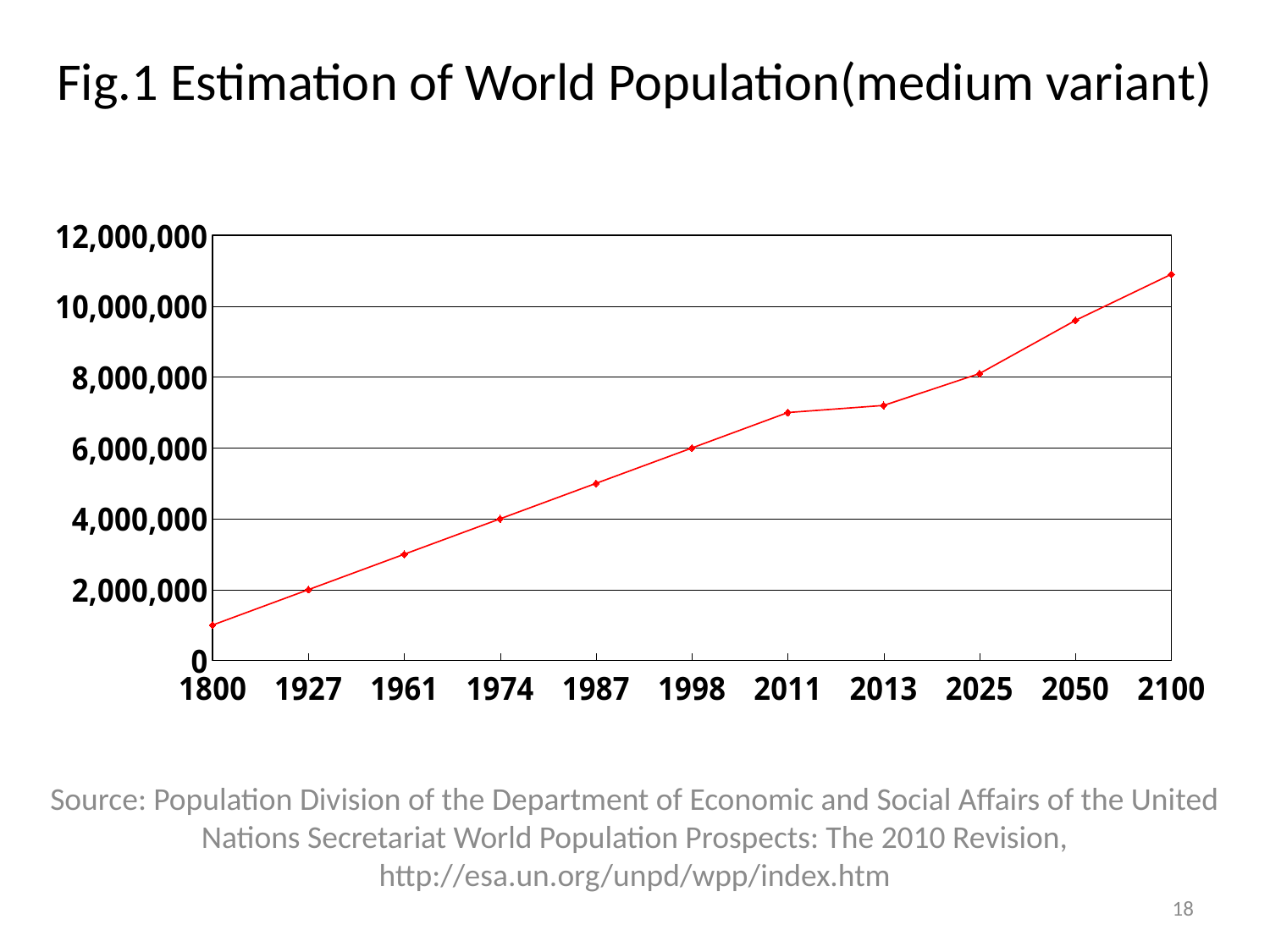
What is the value for 1998? 6,000,000 How many data points are plotted on the line? 11 Which year has the lowest value? 1800 What kind of chart is shown on the slide? line chart Is the value for 1800 greater or less than 2,000,000? less Is the value for 2100 greater or less than 10,000,000? greater What is the title of the chart? Fig.1 Estimation of World Population(medium variant) Which year has the highest value? 2100 What is the value for 1927? 2,000,000 What is the value for 1974? 4,000,000 Is the value for 2050 greater or less than 8,000,000? greater Do the values rise or fall from 1800 to 2100? rise